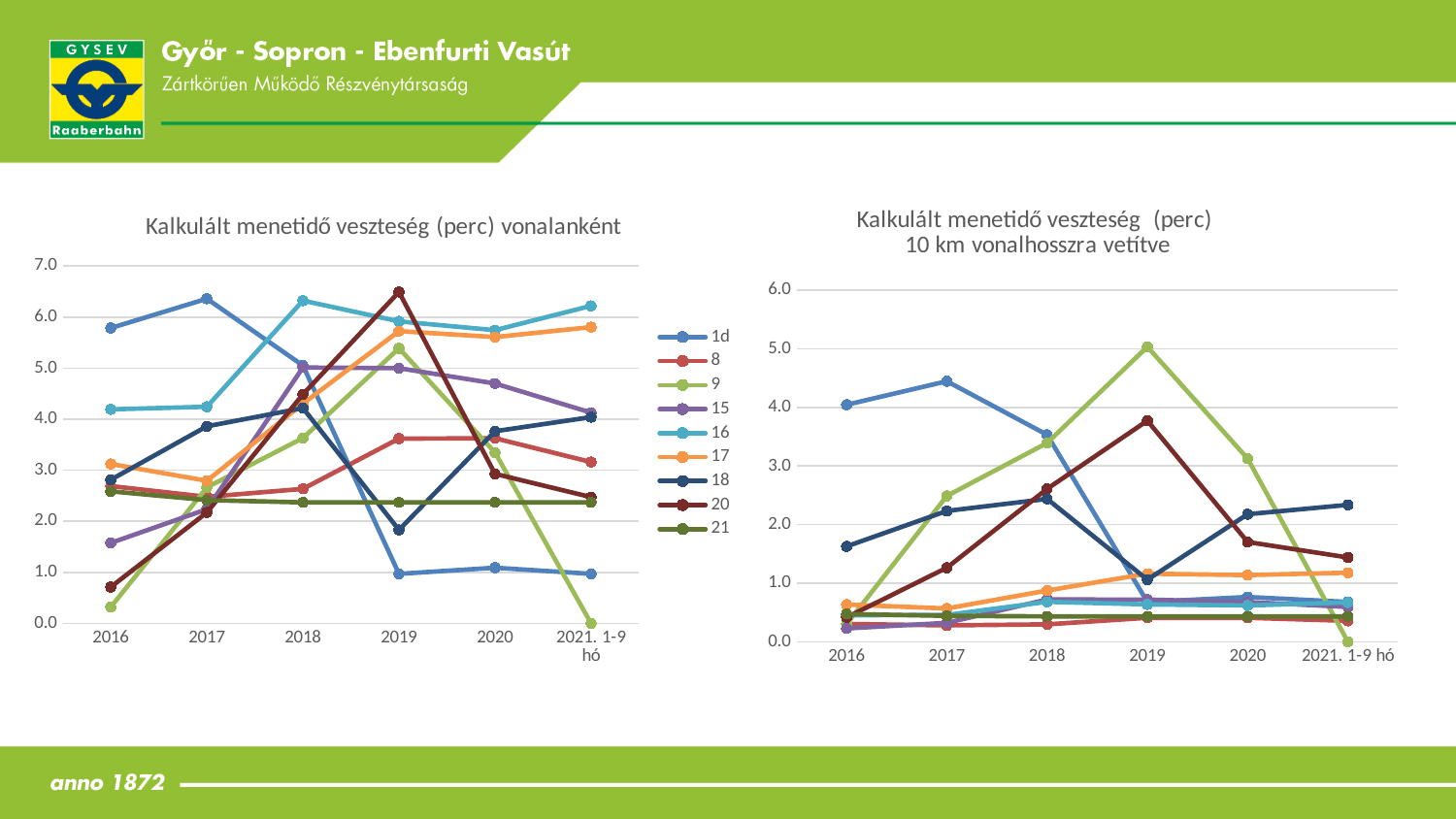
In the left chart, is the value for series 1d in 2019 greater or less than 2.0? less In the right chart, is the highest value plotted in 2019 greater or less than 4.0? greater What kind of chart is the left chart, 'Kalkulált menetidő veszteség (perc) vonalanként'? line chart How many series does the legend of the left chart list? 9 In the left chart, which is larger in 2016: series 1d or series 9? 1d In the left chart, is the value for series 16 in 2018 greater or less than 6.0? greater In the left chart, does series 1d rise or fall from 2018 to 2019? fall How many points are on the x axis of the right chart? 6 In the left chart, which series has the highest value in 2019? 20 What kind of chart is the right chart, 'Kalkulált menetidő veszteség (perc) 10 km vonalhosszra vetítve'? line chart How many points are on the x axis of the left chart? 6 In the left chart, which series has the lowest value in 2021. 1-9 hó? 9